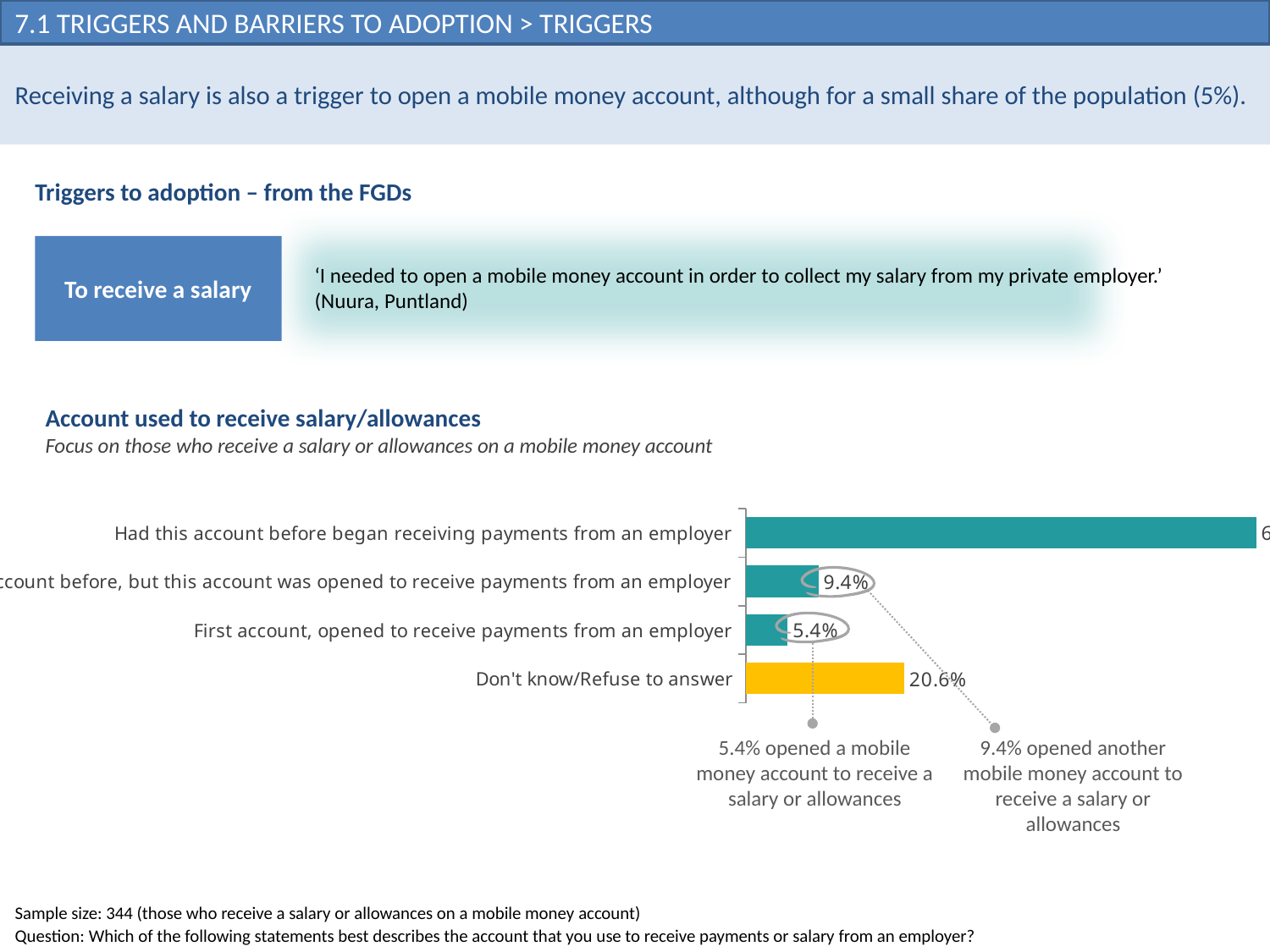
Which category has the lowest value in the chart? First account, opened to receive payments from an employer Which category's bar is coloured yellow rather than teal? Don't know/Refuse to answer What is the sample size stated below the chart? 344 What is the value for 'First account, opened to receive payments from an employer'? 5.4% What kind of chart is shown under 'Account used to receive salary/allowances'? bar chart Which category has the highest value in the chart? Had this account before began receiving payments from an employer Which is larger: the value for 'Don't know/Refuse to answer' or the value for 'First account, opened to receive payments from an employer'? Don't know/Refuse to answer What is the difference between the value for 'Don't know/Refuse to answer' and the value for 'First account, opened to receive payments from an employer'? 15.2% What is the value for 'Don't know/Refuse to answer'? 20.6% According to the callout text, what share opened another mobile money account to receive a salary or allowances? 9.4% How many categories does the 'Account used to receive salary/allowances' chart show? 4